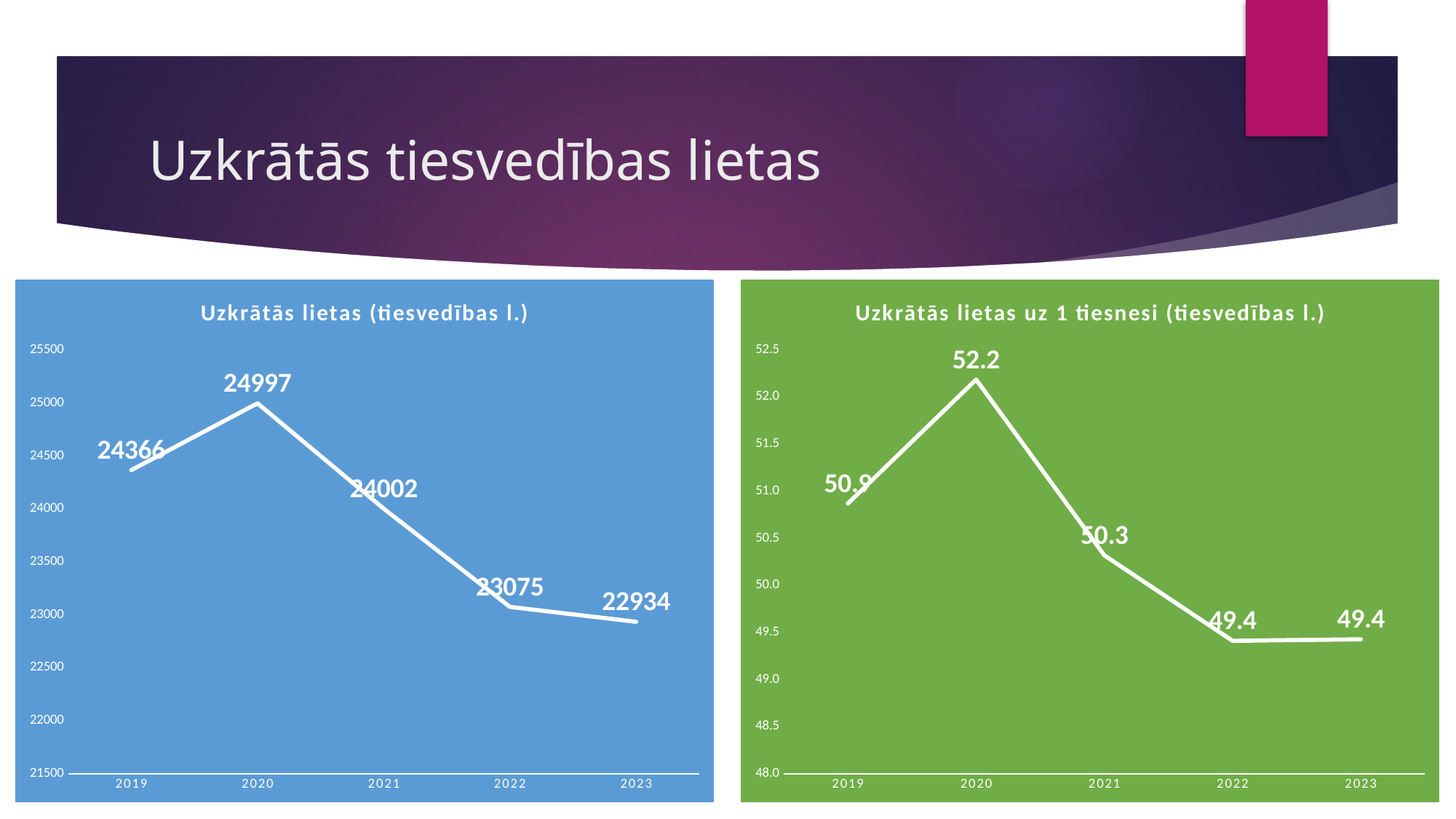
In the chart titled "Uzkrātās lietas (tiesvedības l.)", what is the value for 2020? 24997 In the chart titled "Uzkrātās lietas uz 1 tiesnesi (tiesvedības l.)", what is the value for 2019? 50.9 In the chart titled "Uzkrātās lietas (tiesvedības l.)", what is the value for 2023? 22934 In the chart titled "Uzkrātās lietas uz 1 tiesnesi (tiesvedības l.)", what is the value for 2021? 50.3 In the chart titled "Uzkrātās lietas (tiesvedības l.)", how many years are plotted? 5 In the chart titled "Uzkrātās lietas (tiesvedības l.)", which year has the lowest value? 2023 In the chart titled "Uzkrātās lietas uz 1 tiesnesi (tiesvedības l.)", which year has the highest value? 2020 In the chart titled "Uzkrātās lietas (tiesvedības l.)", which year has the highest value? 2020 What kind of chart is the chart titled "Uzkrātās lietas (tiesvedības l.)"? line chart In the chart titled "Uzkrātās lietas (tiesvedības l.)", what is the difference between the values for 2020 and 2021? 995 In the chart titled "Uzkrātās lietas uz 1 tiesnesi (tiesvedības l.)", do the values rise or fall from 2020 to 2022? fall In the chart titled "Uzkrātās lietas uz 1 tiesnesi (tiesvedības l.)", what is the difference between the values for 2020 and 2022? 2.8